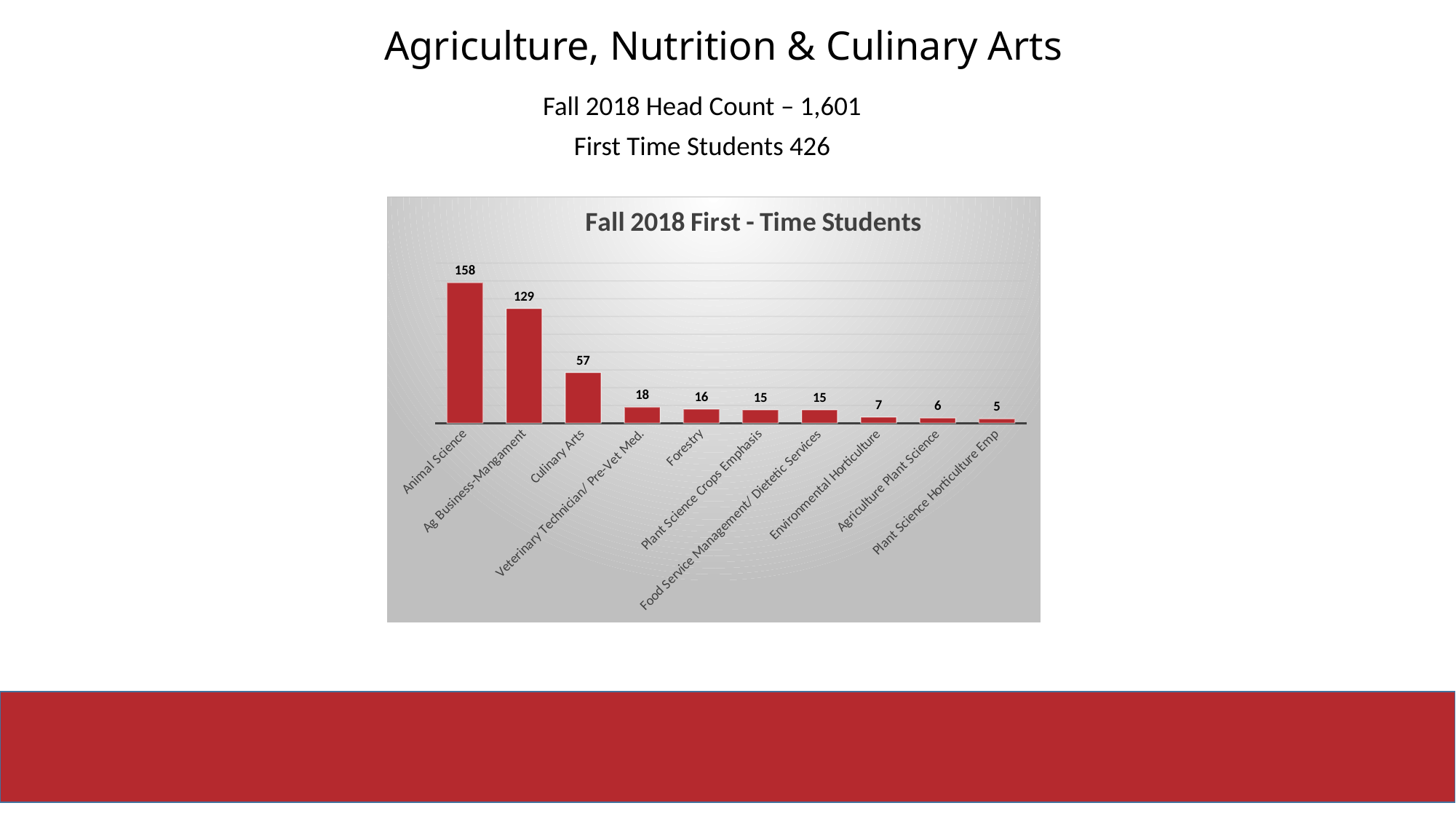
What is the difference between the values for Culinary Arts and Veterinary Technician/ Pre-Vet Med.? 39 What is the difference between the values for Animal Science and Ag Business-Mangament? 29 Which is larger, the value for Environmental Horticulture or the value for Agriculture Plant Science? Environmental Horticulture What kind of chart is shown? Bar chart How many categories are shown on the chart? 10 Do the values rise or fall from left to right along the x axis? Fall What is the value for Forestry? 16 Which category has the lowest value? Plant Science Horticulture Emp Which category has the highest value? Animal Science What is the title of the chart? Fall 2018 First - Time Students What is the value for Animal Science? 158 What is the value for Culinary Arts? 57